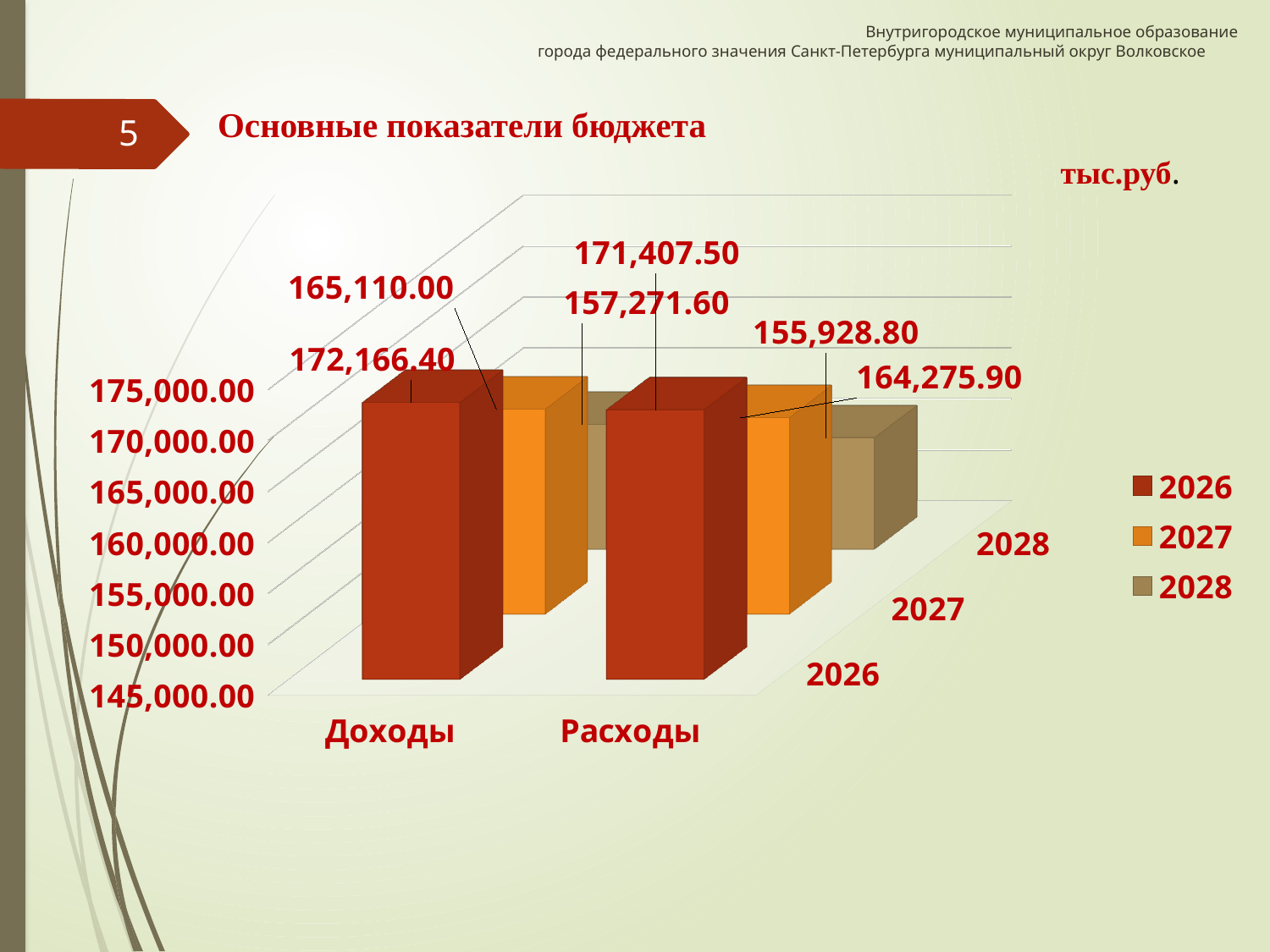
What type of chart is shown on the slide? bar chart What is the value of Доходы for 2028? 157,271.60 What is the value of Доходы for 2027? 165,110.00 What unit is stated above the chart? тыс.руб. What is the value of Доходы for 2026? 172,166.40 Which is larger in 2027: Доходы or Расходы? Доходы How many categories are shown on the x axis? 2 What is the value of Расходы for 2028? 155,928.80 What is the value of Расходы for 2026? 171,407.50 What is the difference between Расходы and Доходы in 2028? 1,342.80 What is the difference between Доходы and Расходы in 2027? 834.10 How many series does the legend list? 3